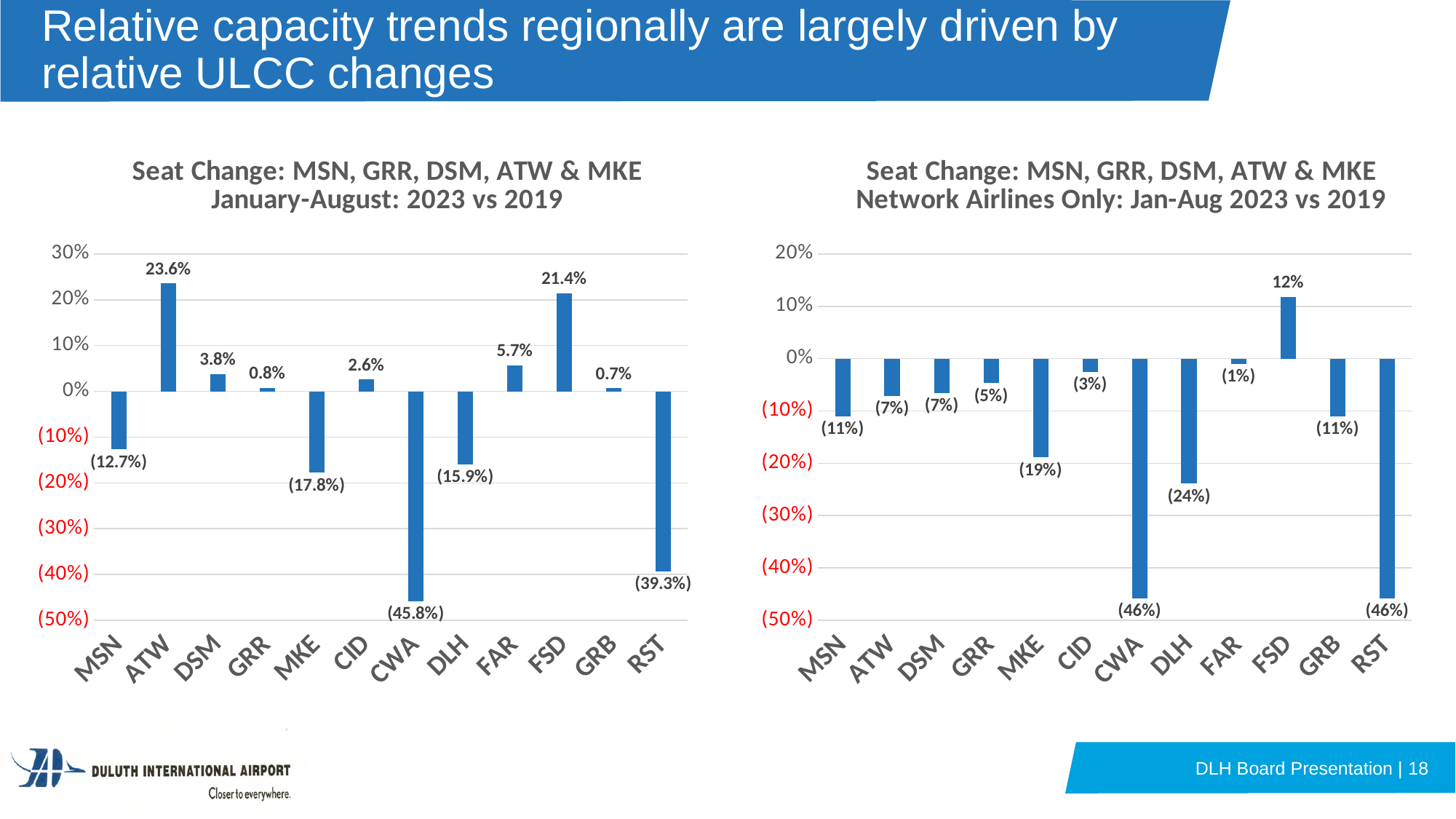
How many airports are shown on the x axis of the left chart? 12 In the left chart (January-August: 2023 vs 2019), what is the seat change for DLH? (15.9%) In the left chart (January-August: 2023 vs 2019), how much higher is ATW's seat change than FSD's? 2.2 percentage points In the right chart (Network Airlines Only), which is larger, the seat change for FAR or the seat change for GRB? FAR In the right chart (Network Airlines Only), which airport has the highest seat change? FSD What type of chart is the right chart (Network Airlines Only)? Bar chart In the left chart (January-August: 2023 vs 2019), which airport has the highest seat change? ATW In the right chart (Network Airlines Only), what is the seat change for MKE? (19%) What is the title of the right chart? Seat Change: MSN, GRR, DSM, ATW & MKE Network Airlines Only: Jan-Aug 2023 vs 2019 In the left chart (January-August: 2023 vs 2019), which airport has the lowest seat change? CWA In the right chart (Network Airlines Only), what is the seat change for DLH? (24%) In the left chart (January-August: 2023 vs 2019), what is the seat change for ATW? 23.6%